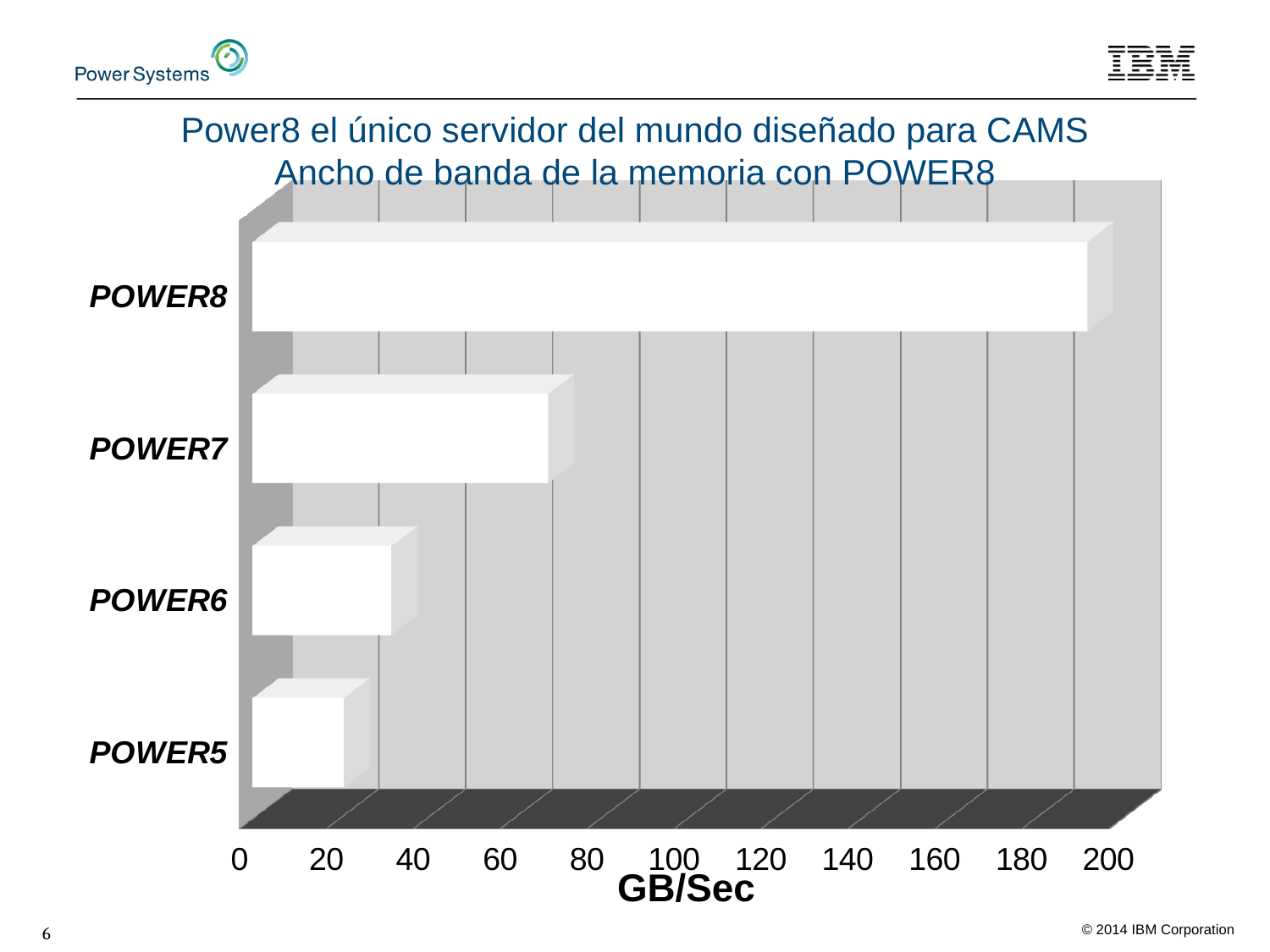
Do the values increase or decrease going from POWER5 to POWER8? increase Which processor has the lowest memory bandwidth in the chart? POWER5 Which has the larger value, POWER7 or POWER6? POWER7 What kind of chart is shown on the slide? bar chart Which processor has the highest memory bandwidth in the chart? POWER8 Is the value for POWER7 greater or less than 80? less How many processor generations are plotted in the chart? 4 Is the value for POWER5 greater or less than 40? less What unit is shown on the horizontal axis of the chart? GB/Sec Is the value for POWER8 greater or less than 180? greater